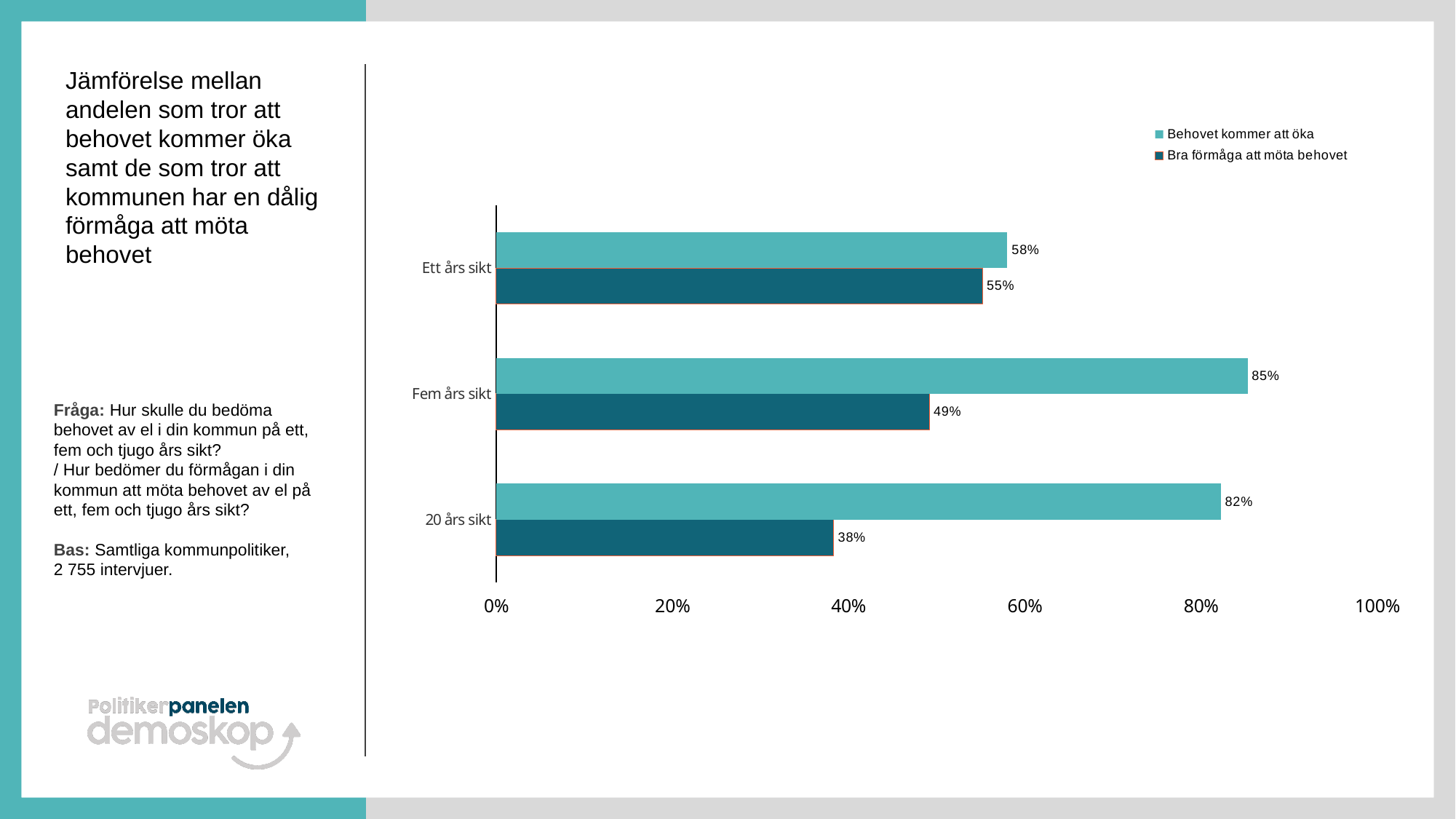
What kind of chart is shown on the slide? Bar chart How many series does the legend list? 2 Which category has the lowest value for "Bra förmåga att möta behovet"? 20 års sikt Is the value for "Bra förmåga att möta behovet" at "Ett års sikt" greater or less than 40%? greater Does the value for "Bra förmåga att möta behovet" rise or fall from "Ett års sikt" to "20 års sikt"? Fall What is the value for "Behovet kommer att öka" at "Ett års sikt"? 58% What is the value for "Bra förmåga att möta behovet" at "20 års sikt"? 38% What is the value for "Bra förmåga att möta behovet" at "Fem års sikt"? 49% How many categories are shown on the chart? 3 Which is larger at "Fem års sikt": "Behovet kommer att öka" or "Bra förmåga att möta behovet"? Behovet kommer att öka Which category has the highest value for "Behovet kommer att öka"? Fem års sikt What is the difference between "Behovet kommer att öka" and "Bra förmåga att möta behovet" at "20 års sikt"? 44 percentage points